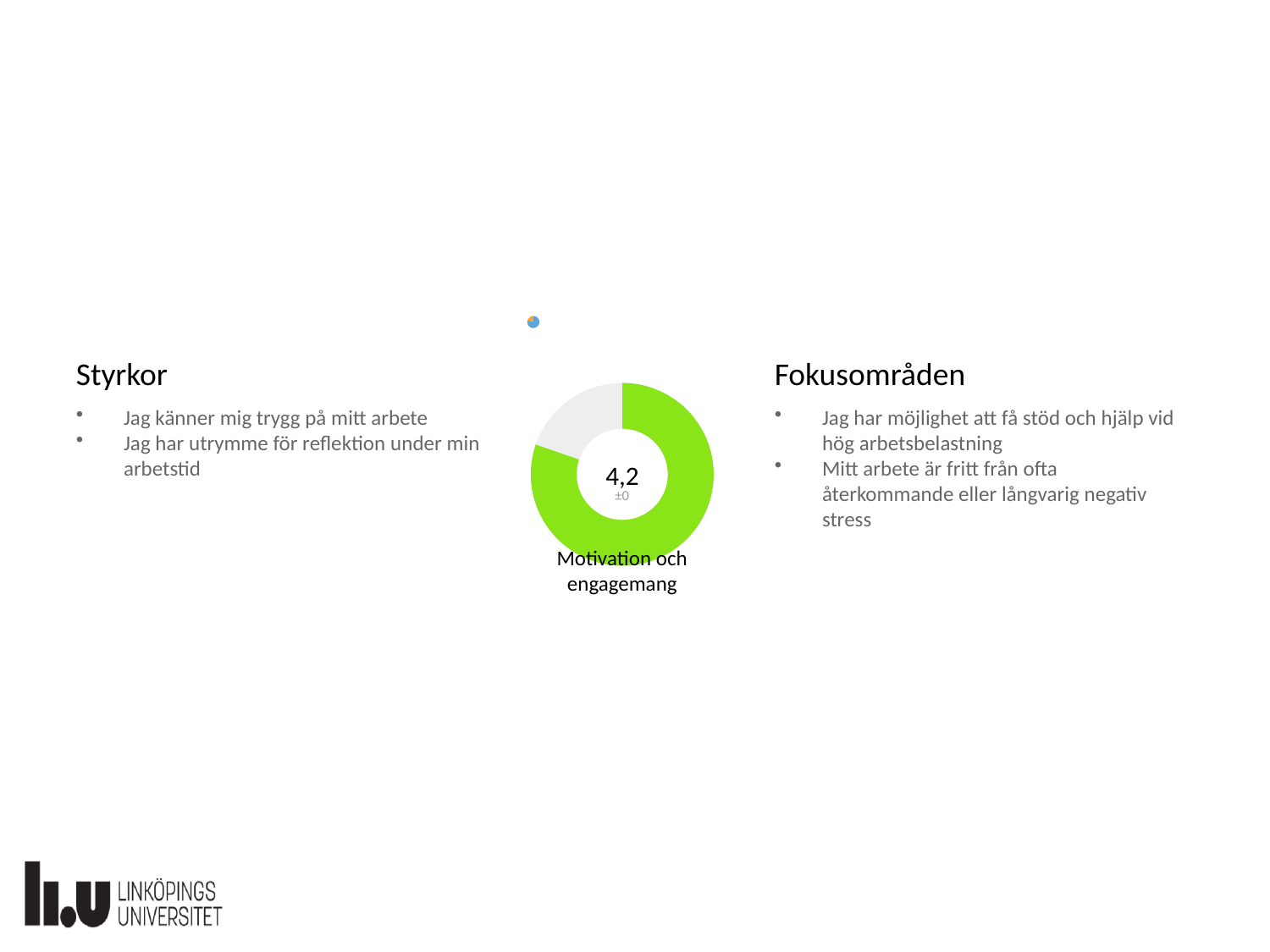
What kind of chart is shown in the centre of the slide? Donut chart Which segment of the donut chart is larger, the green one or the grey one? The green one What colour is the largest segment of the donut chart? Green How many segments does the donut chart have? 2 What label appears below the donut chart? Motivation och engagemang What small value is printed directly under the 4,2 in the centre of the donut chart? ±0 What value is printed in the centre of the donut chart? 4,2